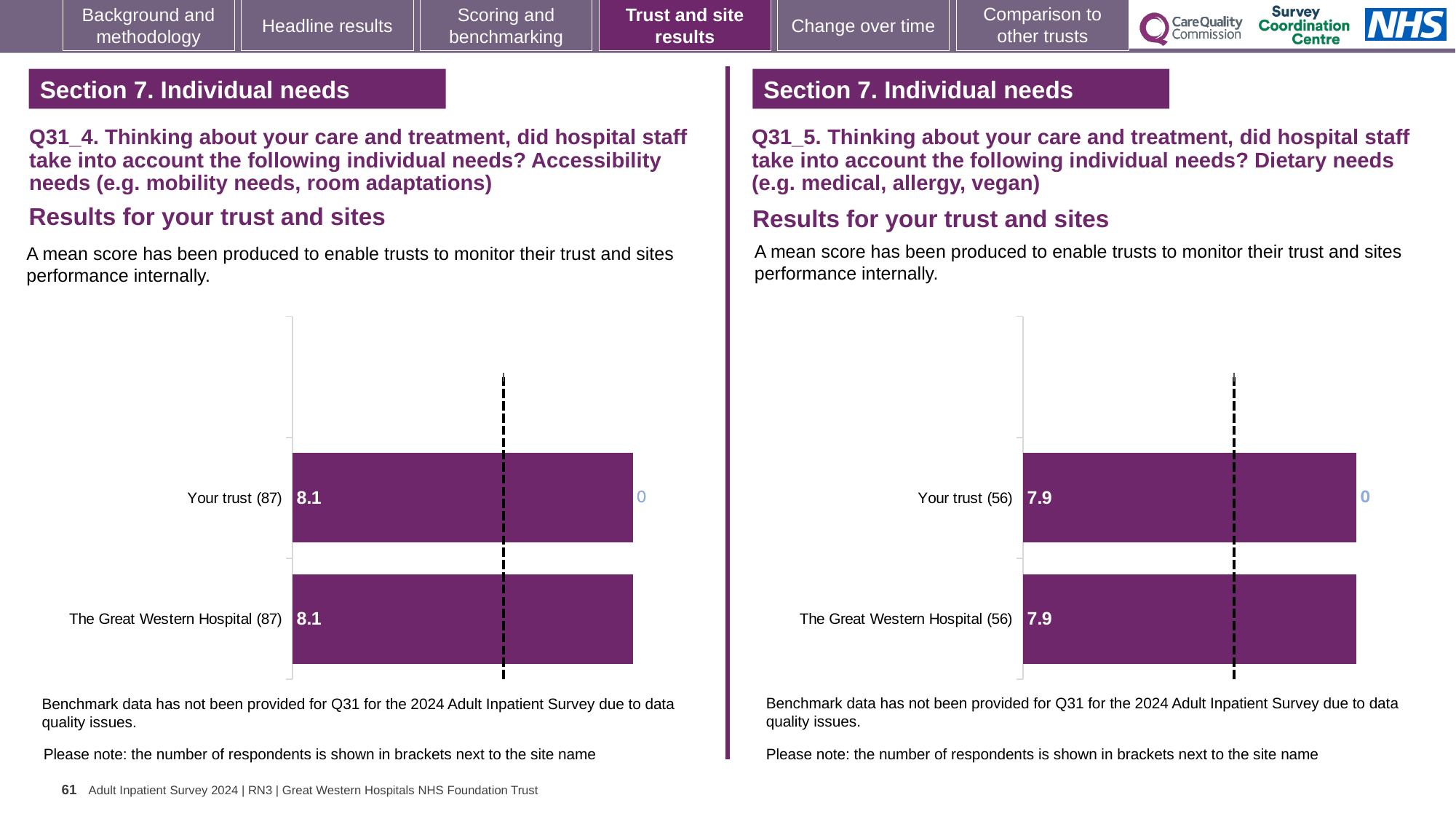
How many bars are plotted in the left chart (Q31_4, accessibility needs)? 2 In the left chart (Q31_4, accessibility needs), what is the difference between the scores for Your trust and The Great Western Hospital? 0.0 In the left chart (Q31_4, accessibility needs), how many respondents are shown in brackets next to Your trust? 87 In the right chart (Q31_5, dietary needs), what is the difference between the scores for Your trust and The Great Western Hospital? 0.0 In the right chart (Q31_5, dietary needs), what is the mean score for Your trust? 7.9 In the right chart (Q31_5, dietary needs), how many respondents are shown in brackets next to The Great Western Hospital? 56 In the left chart (Q31_4, accessibility needs), what is the mean score for The Great Western Hospital? 8.1 What kind of chart is used in the left chart (Q31_4, accessibility needs)? Bar chart How many bars are plotted in the right chart (Q31_5, dietary needs)? 2 In the right chart (Q31_5, dietary needs), what is the mean score for The Great Western Hospital? 7.9 In the left chart (Q31_4, accessibility needs), what is the mean score for Your trust? 8.1